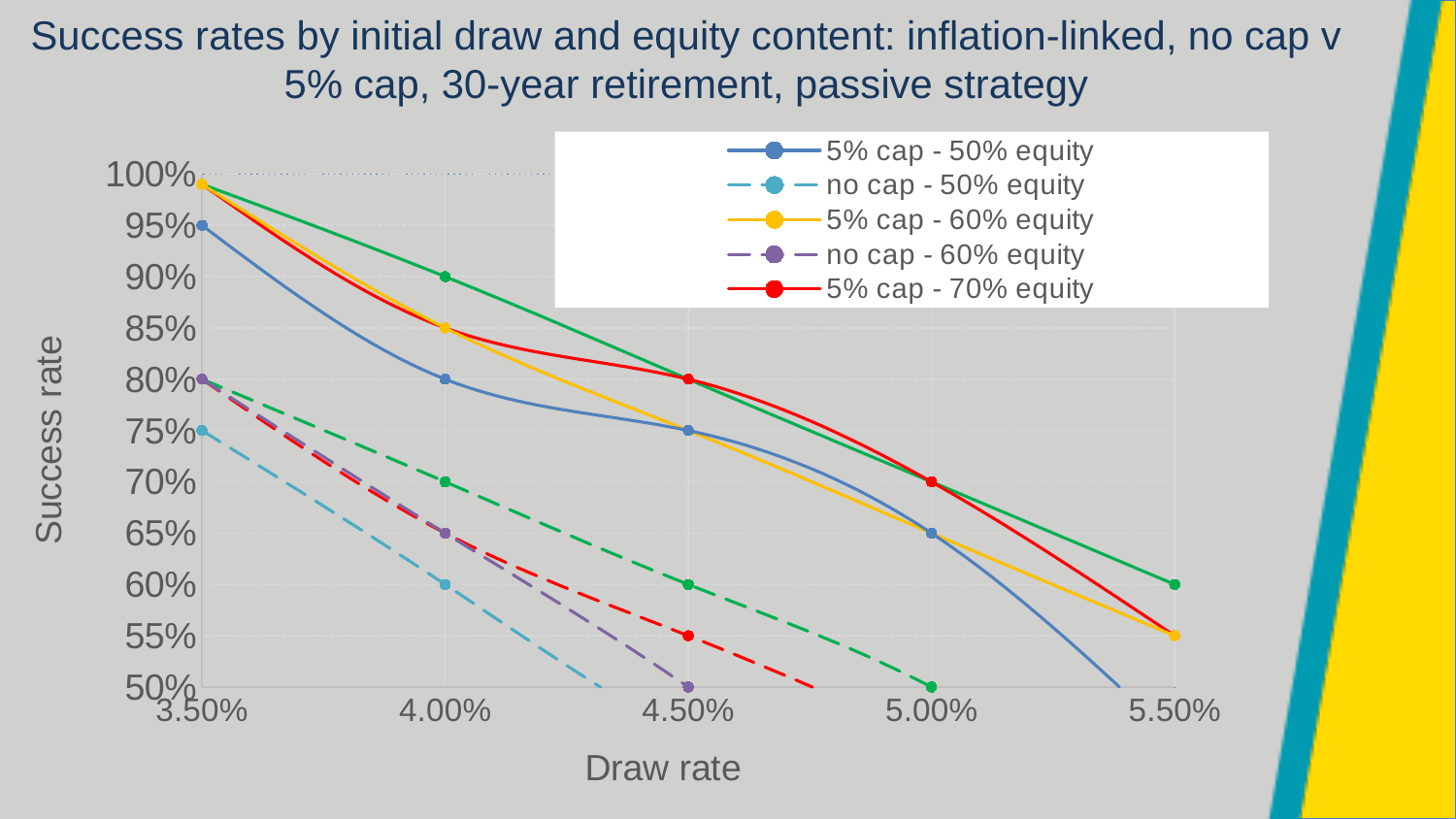
What is the success rate for '5% cap - 50% equity' at a 5.00% draw rate? 65% What is the success rate for '5% cap - 50% equity' at a 3.50% draw rate? 95% What is the label of the x axis? Draw rate Do the success rates rise or fall as the draw rate increases? fall What is the success rate for 'no cap - 60% equity' at a 3.50% draw rate? 80% How many draw rates are labelled on the x axis? 5 What is the success rate for 'no cap - 50% equity' at a 4.00% draw rate? 60% What is the success rate for '5% cap - 70% equity' at a 5.00% draw rate? 70% What is the success rate for '5% cap - 70% equity' at a 5.50% draw rate? 55% What kind of chart is shown on the slide? line chart What is the difference between '5% cap - 70% equity' and 'no cap - 60% equity' at a 4.00% draw rate? 20% At a 4.00% draw rate, which is higher: '5% cap - 50% equity' or 'no cap - 50% equity'? 5% cap - 50% equity